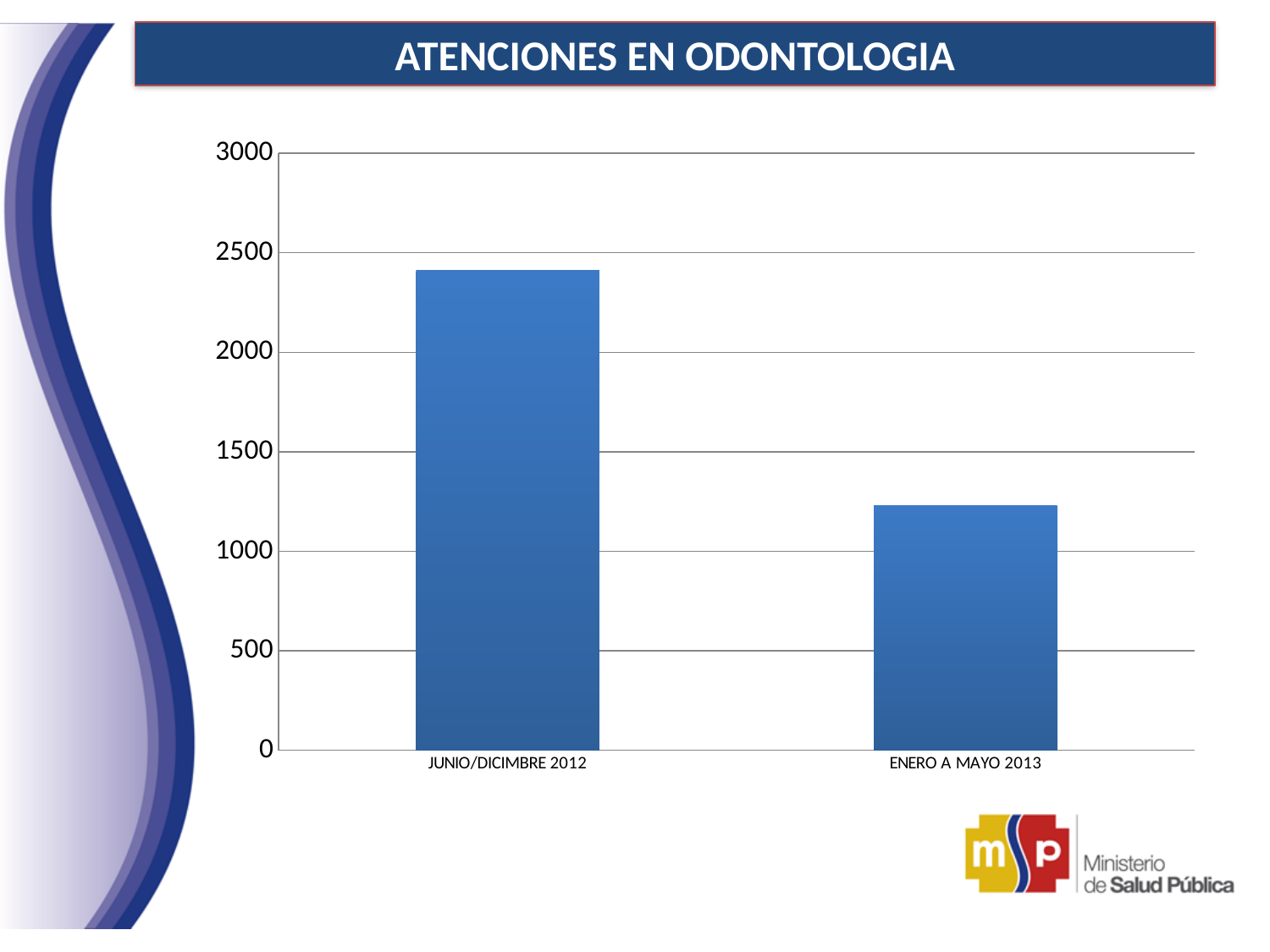
Is the value for ENERO A MAYO 2013 greater or less than 1000? greater Is the value for JUNIO/DICIMBRE 2012 greater or less than 2500? less What is the title of the slide above the chart? ATENCIONES EN ODONTOLOGIA How many categories are plotted in the chart? 2 What kind of chart is shown on the slide? bar chart Which category has the lowest value? ENERO A MAYO 2013 Is the value for JUNIO/DICIMBRE 2012 greater or less than 2000? greater What is the highest value shown on the vertical axis? 3000 Which category has the highest value? JUNIO/DICIMBRE 2012 Do the values rise or fall from left to right along the x axis? fall Which is larger, the value for JUNIO/DICIMBRE 2012 or the value for ENERO A MAYO 2013? JUNIO/DICIMBRE 2012